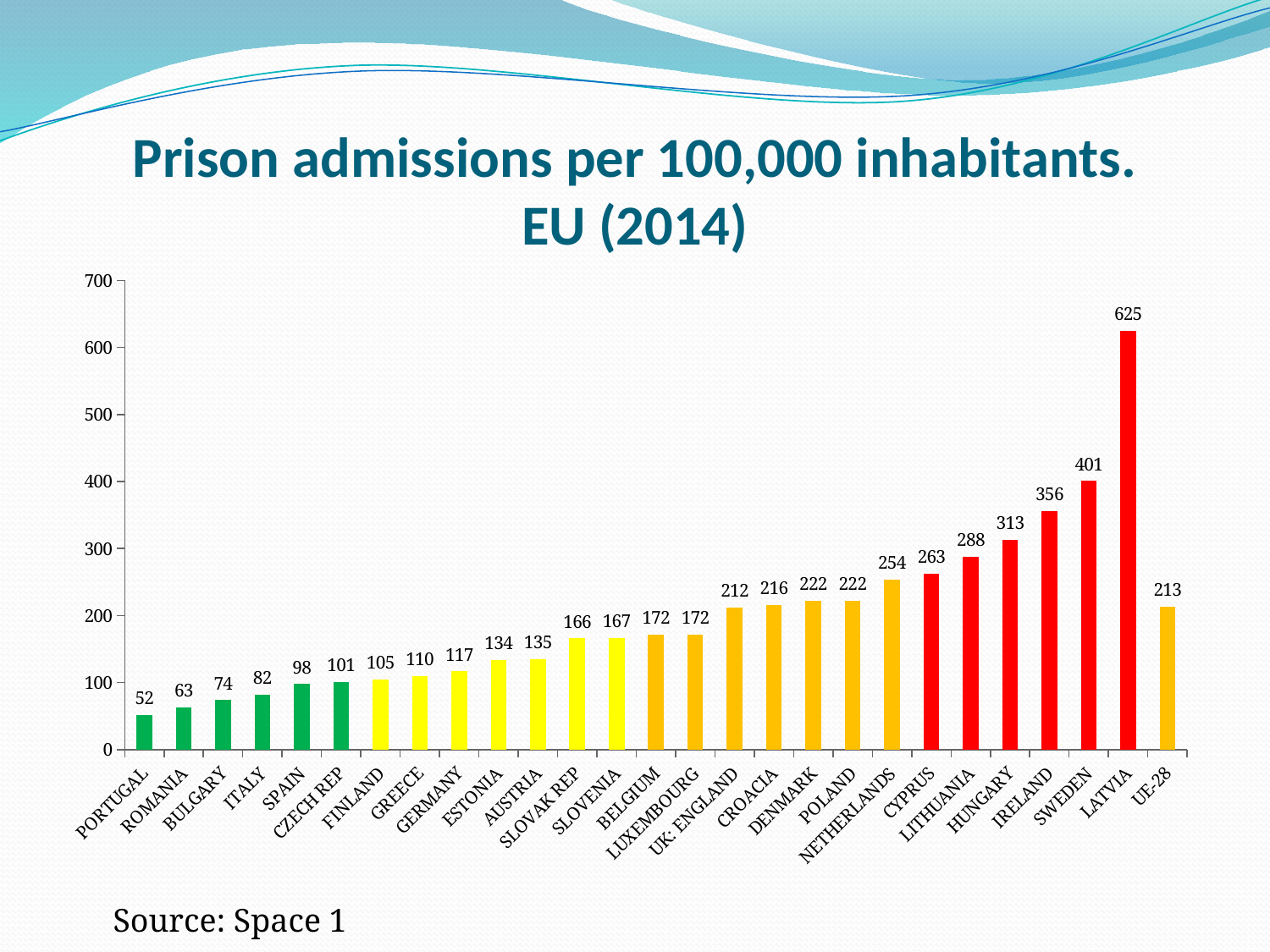
What kind of chart is shown on the slide? Bar chart What is the value for Latvia? 625 What is the value for Portugal? 52 What is the value for Netherlands? 254 Which country has the lowest prison admissions per 100,000 inhabitants? Portugal What is the title of the chart? Prison admissions per 100,000 inhabitants. EU (2014) What is the value for UE-28? 213 How many bars are shown in the chart? 27 Which country has the highest prison admissions per 100,000 inhabitants? Latvia What is the difference between the values for Latvia and Sweden? 224 Which has a higher value, Hungary or Lithuania? Hungary Is the value for Ireland greater or less than 300? greater